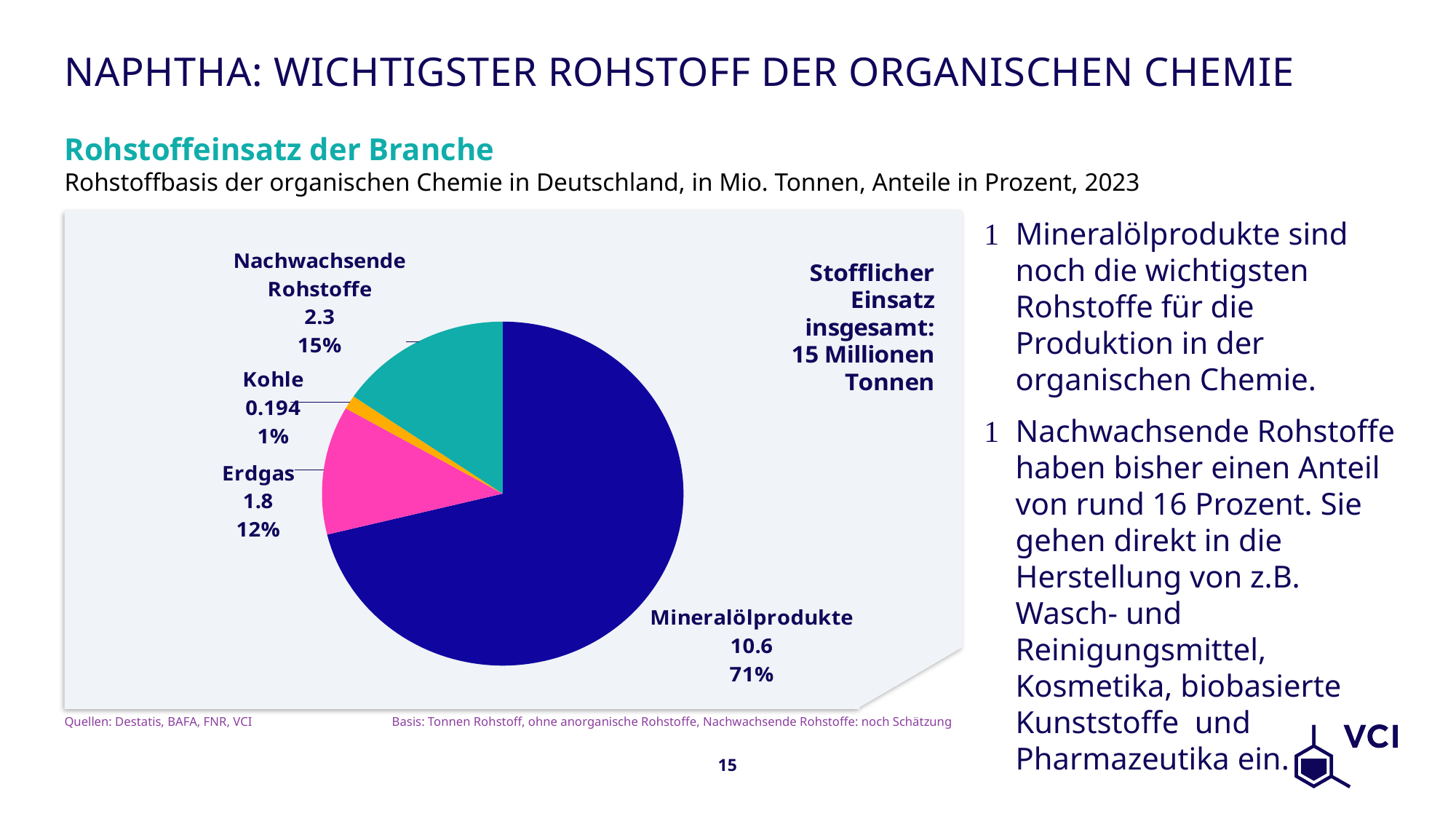
What is the difference in Mio. Tonnen between Mineralölprodukte and Erdgas? 8.8 What percentage share does Erdgas have? 12% What is the value for Mineralölprodukte in Mio. Tonnen? 10.6 Which category has the largest share of the pie? Mineralölprodukte Which category has the smallest share of the pie? Kohle What is the value for Nachwachsende Rohstoffe in Mio. Tonnen? 2.3 What percentage share does Mineralölprodukte have? 71% Which is larger, Nachwachsende Rohstoffe or Erdgas? Nachwachsende Rohstoffe What kind of chart is shown on the slide? Pie chart What is the total stofflicher Einsatz stated on the chart? 15 Millionen Tonnen How many categories are shown in the pie chart? 4 What is the value for Kohle in Mio. Tonnen? 0.194